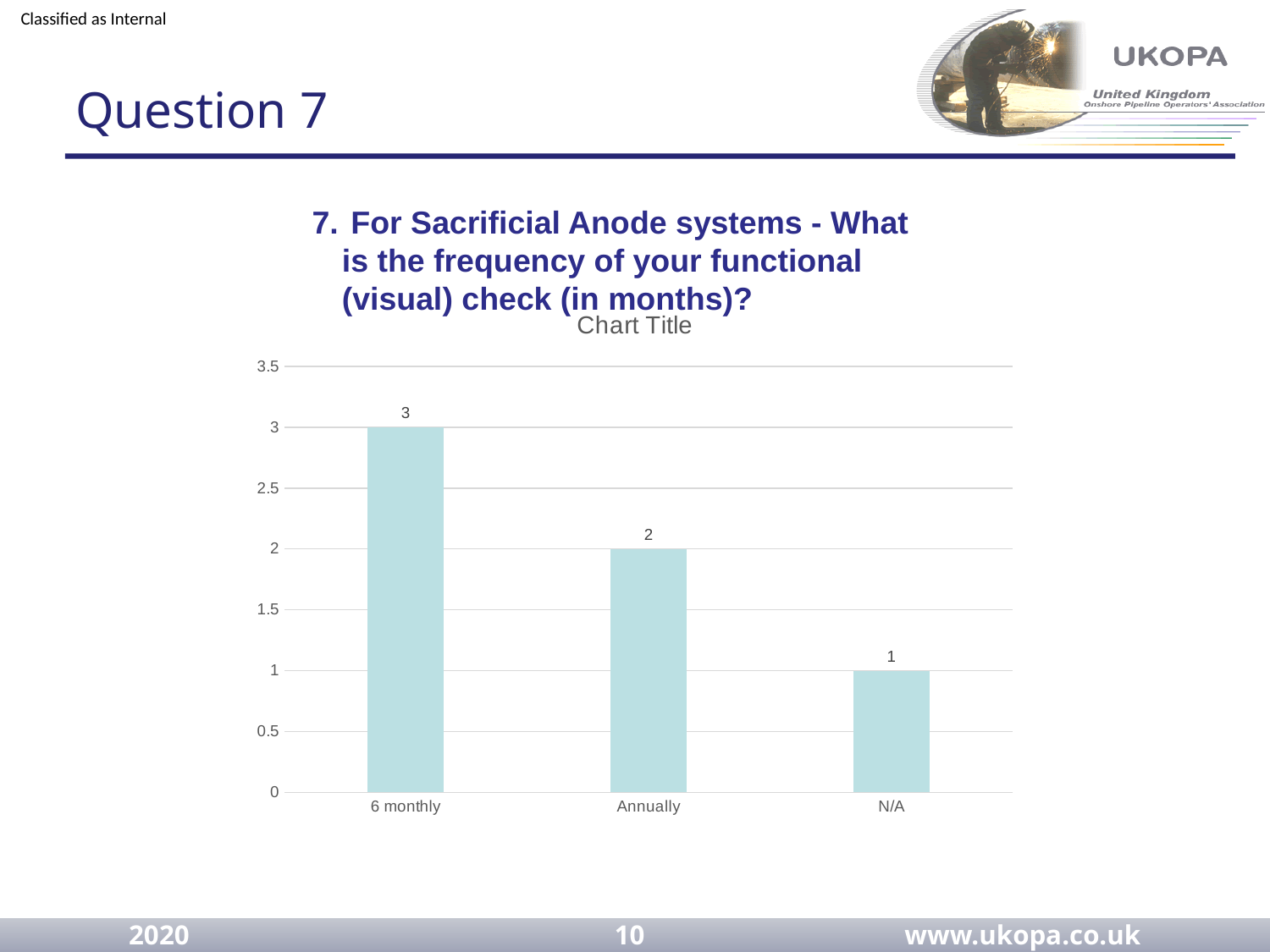
What is the value for N/A? 1 How many categories are shown on the x axis? 3 What is the value for 6 monthly? 3 What is the value for Annually? 2 Which category has the highest value? 6 monthly What is the difference between the values for 6 monthly and Annually? 1 Which is larger, the value for Annually or the value for N/A? Annually What kind of chart is shown? bar chart Which category has the lowest value? N/A What is the difference between the values for 6 monthly and N/A? 2 Do the values rise or fall from left to right along the x axis? fall Is the value for Annually greater or less than 1.5? greater